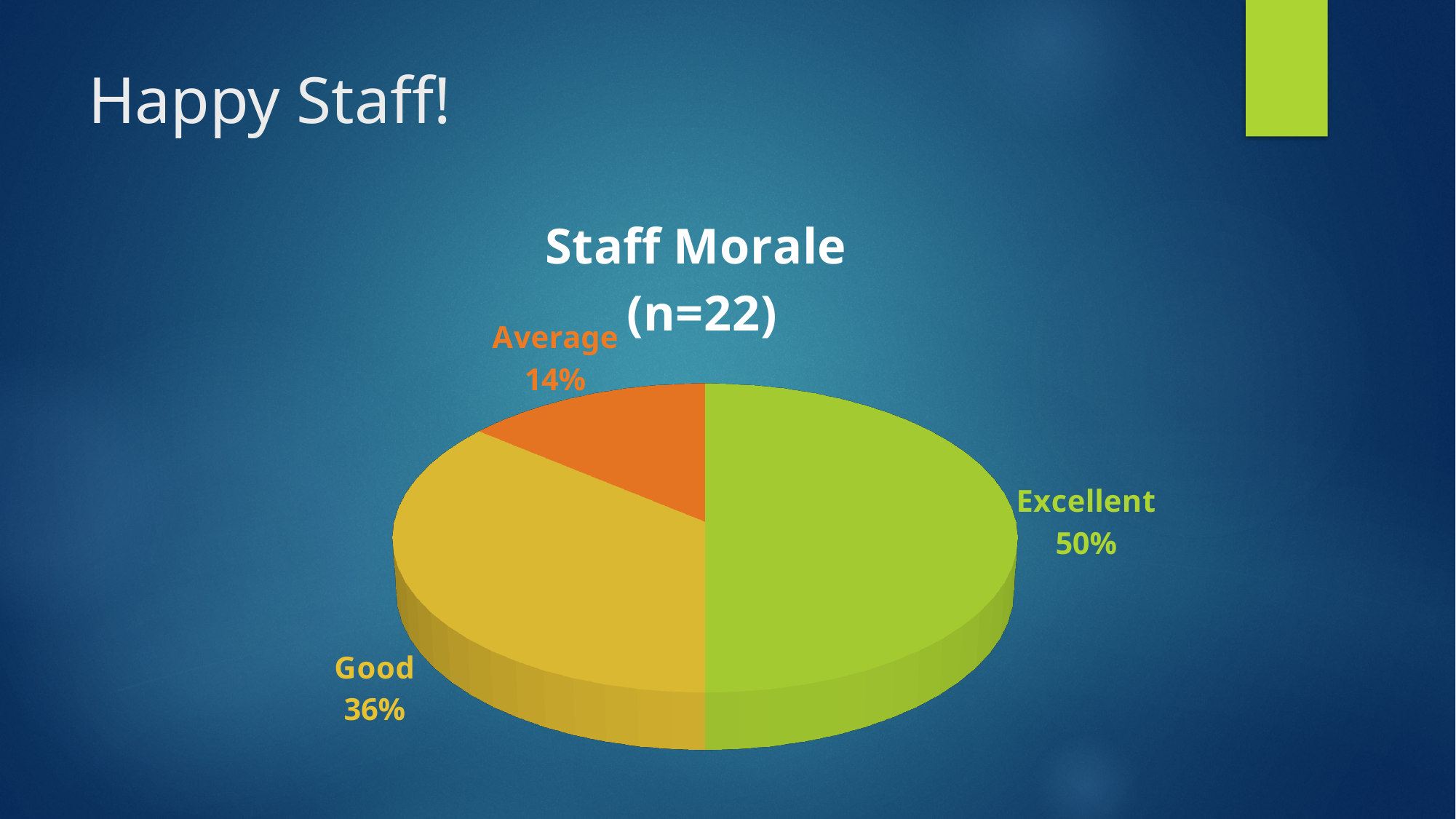
Which category has the largest slice of the pie? Excellent What share of the pie is labelled Average? 14% What share of the pie is labelled Good? 36% Which slice is larger, Good or Average? Good What kind of chart is shown on the slide? pie chart What colour is the Excellent slice? green What is the difference in percentage points between the Good and Average slices? 22 Which category has the smallest slice of the pie? Average What is the difference in percentage points between the Excellent and Good slices? 14 What is the title of the chart? Staff Morale (n=22) What share of the pie is labelled Excellent? 50% How many categories are shown in the pie chart? 3